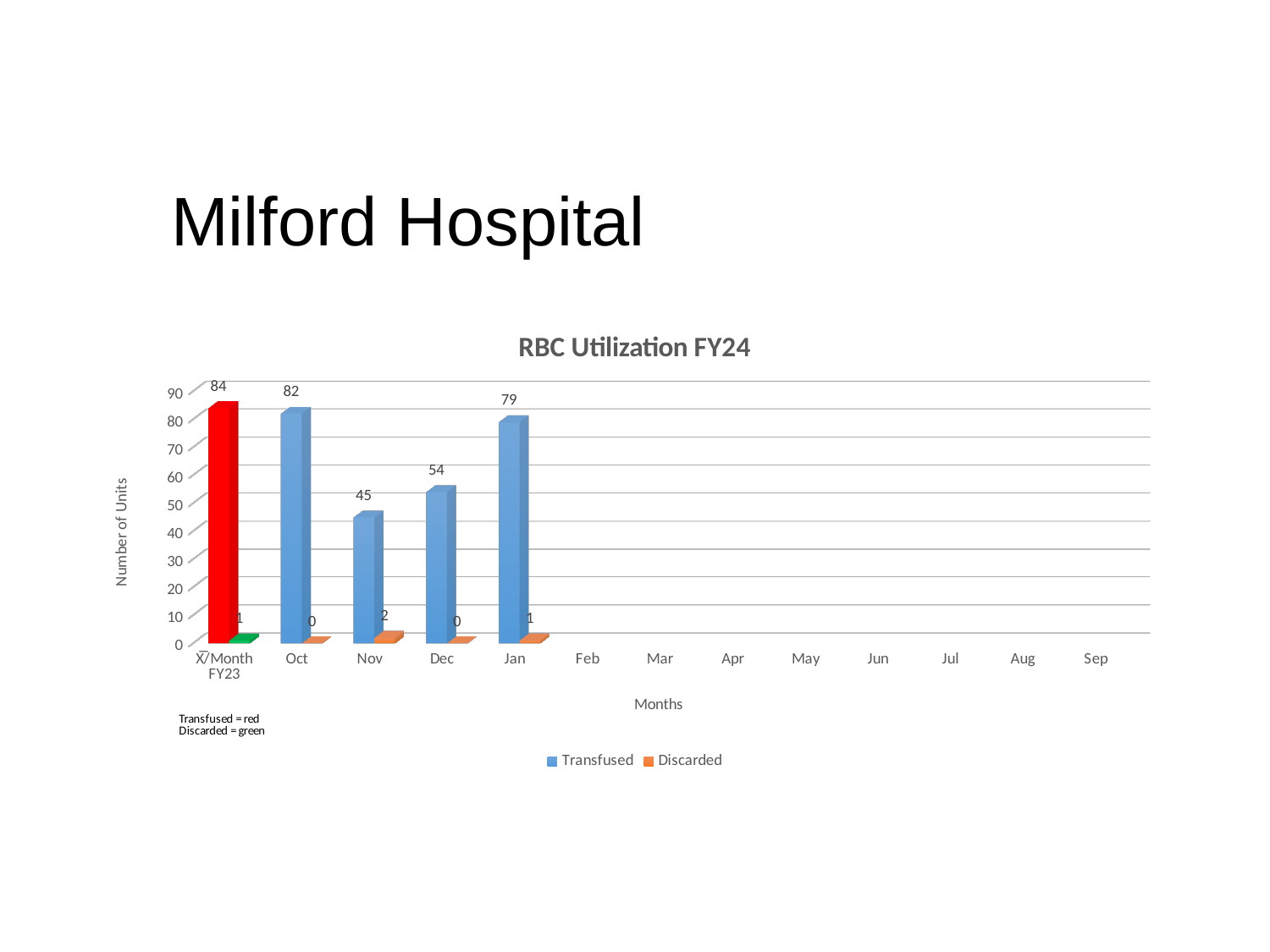
What is the title of the chart? RBC Utilization FY24 How many series does the legend list? 2 Which is larger, the Transfused value for Dec or for Nov? Dec What kind of chart is shown on the slide? Bar chart How many month categories are labelled on the x axis, including X̄/Month FY23? 13 What is the Transfused value for the X̄/Month FY23 category? 84 Which month from Oct to Jan has the highest Transfused value? Oct What is the Discarded value for Nov? 2 What is the Transfused value for Oct? 82 What is the Transfused value for Nov? 45 What is the difference between the Transfused values for Oct and Jan? 3 Which month from Oct to Jan has the lowest Transfused value? Nov